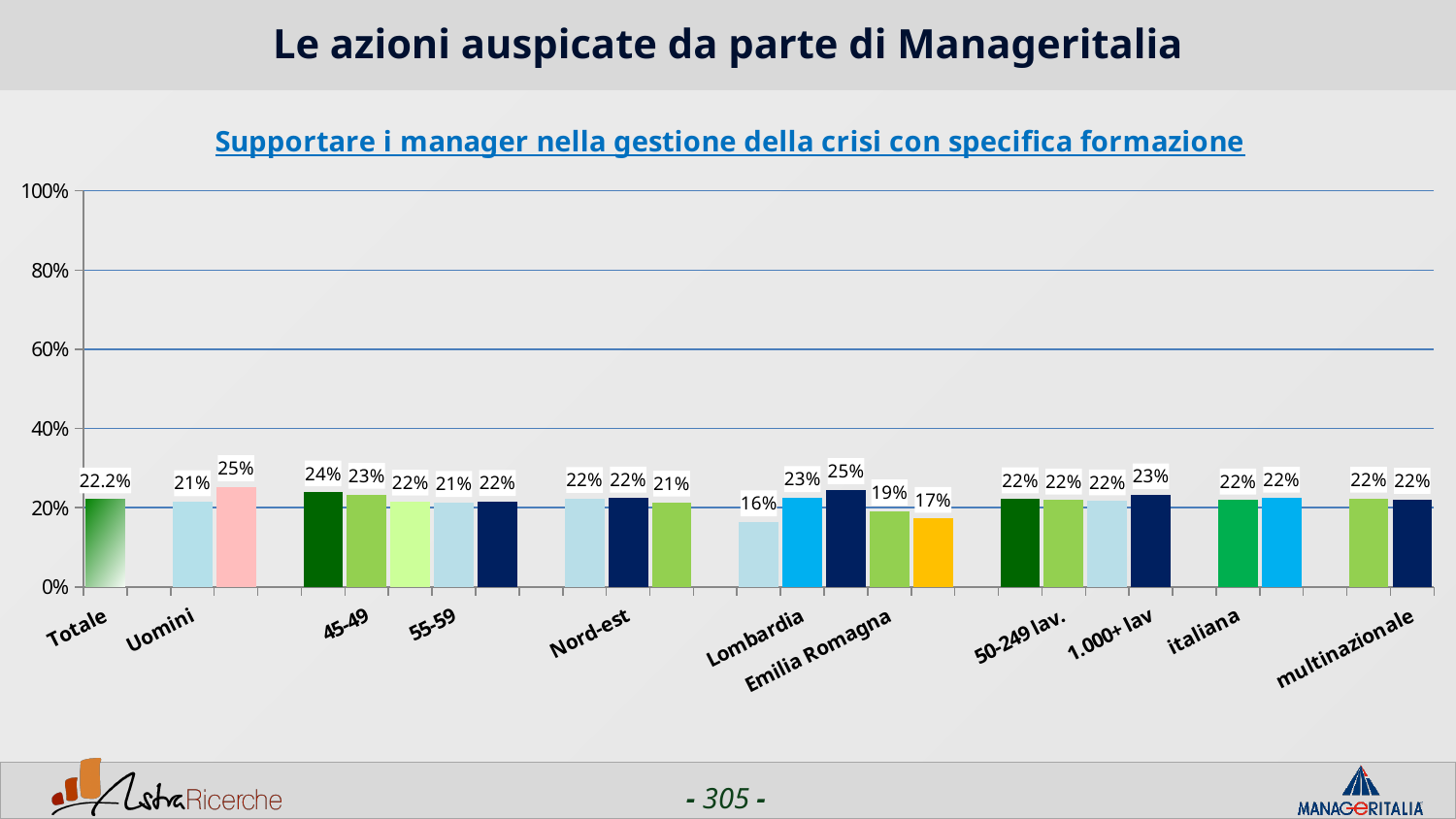
What is the value for Totale? 22.2% What is the subtitle of the chart? Supportare i manager nella gestione della crisi con specifica formazione What is the highest value shown on the vertical axis? 100% Is the value for Totale greater or less than 40%? less What is the difference between the values for Lombardia and Emilia Romagna? 4% What is the value for Emilia Romagna? 19% What kind of chart is shown on the slide? bar chart How many bars are plotted in the chart? 24 What is the value for multinazionale? 22% Which is larger, the value for Lombardia or the value for Emilia Romagna? Lombardia What is the value for Uomini? 21% What is the value for 1.000+ lav? 23%